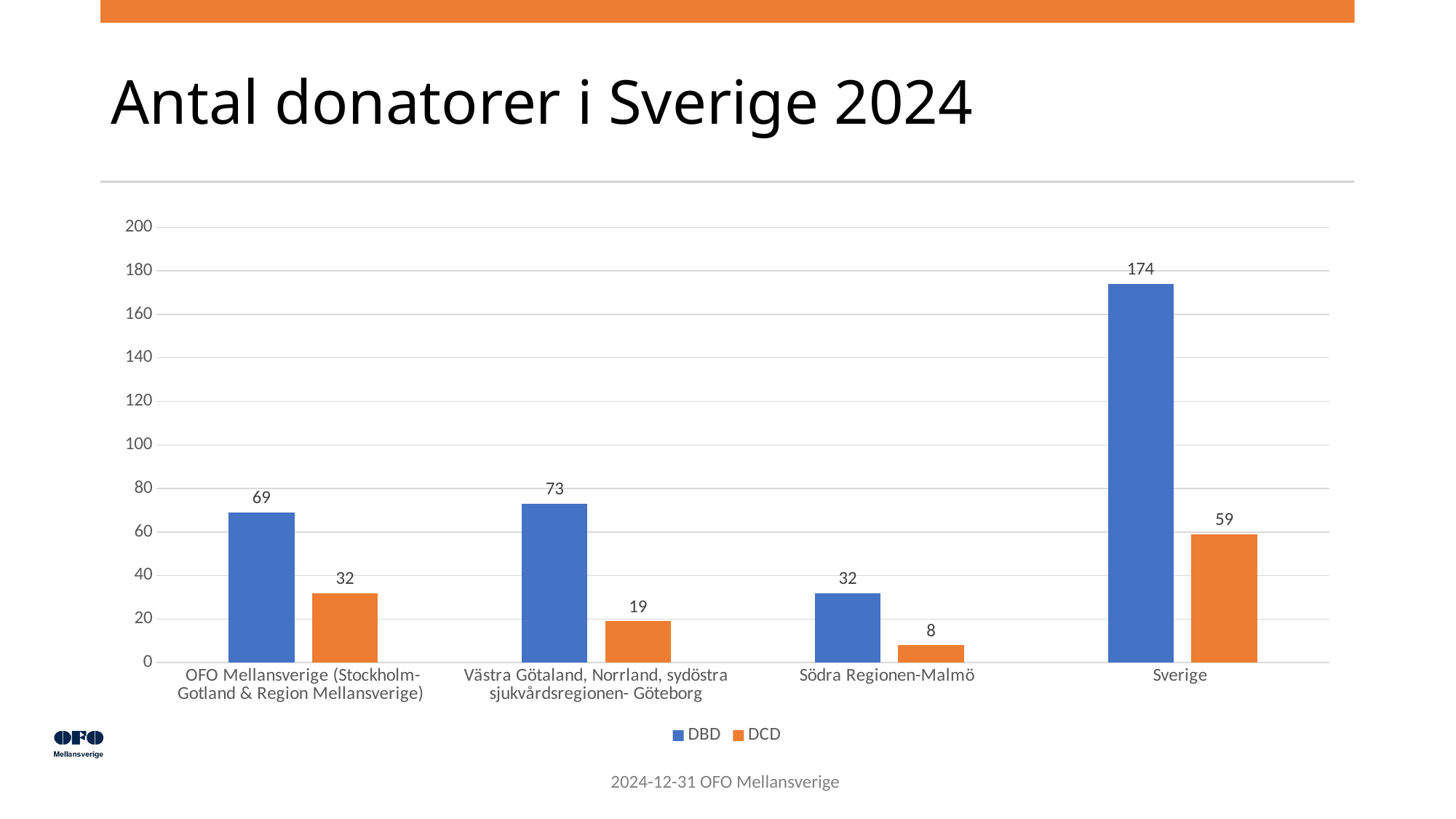
How many categories are shown on the x axis? 4 Which category has the highest DBD value? Sverige Which is larger, the DBD value for OFO Mellansverige or the DBD value for Västra Götaland, Norrland, sydöstra sjukvårdsregionen- Göteborg? Västra Götaland, Norrland, sydöstra sjukvårdsregionen- Göteborg What is the title of the slide? Antal donatorer i Sverige 2024 What is the difference between the DBD and DCD values for Sverige? 115 What is the DCD value for Södra Regionen-Malmö? 8 What is the DCD value for OFO Mellansverige (Stockholm-Gotland & Region Mellansverige)? 32 What is the DBD value for Västra Götaland, Norrland, sydöstra sjukvårdsregionen- Göteborg? 73 What kind of chart is shown on the slide? Bar chart What is the DBD value for Sverige? 174 How many series does the legend list? 2 Which category has the lowest DCD value? Södra Regionen-Malmö